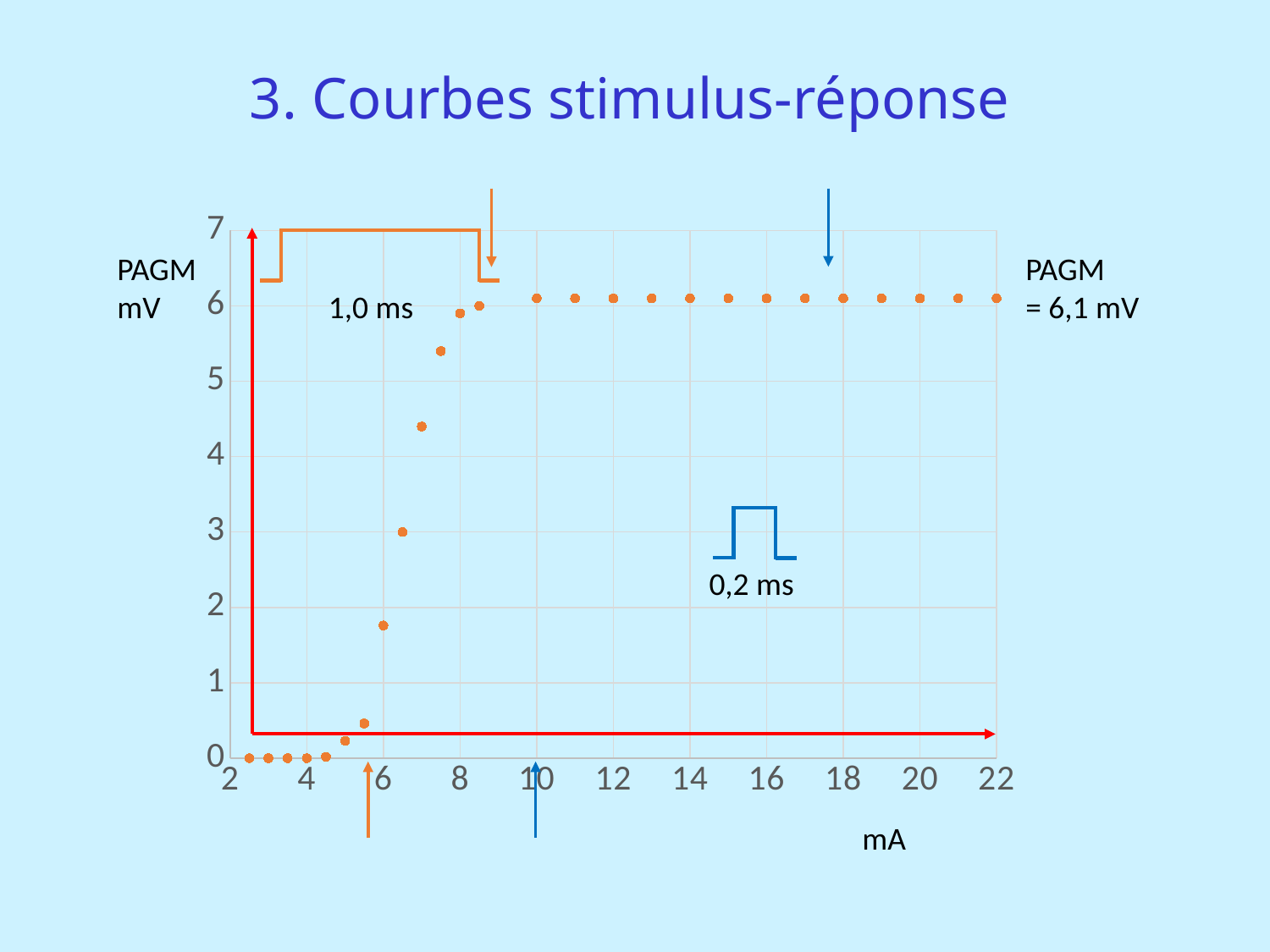
Is the value at 6 mA greater or less than 2? less What is the title of the slide's chart? 3. Courbes stimulus-réponse Do the plotted values rise or fall as the stimulus intensity increases from 5 mA to 9 mA? rise What kind of chart is shown on the slide? scatter chart Is the value at 8 mA greater or less than 5? greater What unit is shown on the x axis of the chart? mA Which is larger, the value at 6.5 mA or the value at 7.5 mA? 7.5 mA What PAGM value does the plateau of the curve reach, according to the annotation on the chart? 6,1 mV Is the value at 16 mA greater or less than 6? greater Which is larger, the value at 6 mA or the value at 8 mA? 8 mA